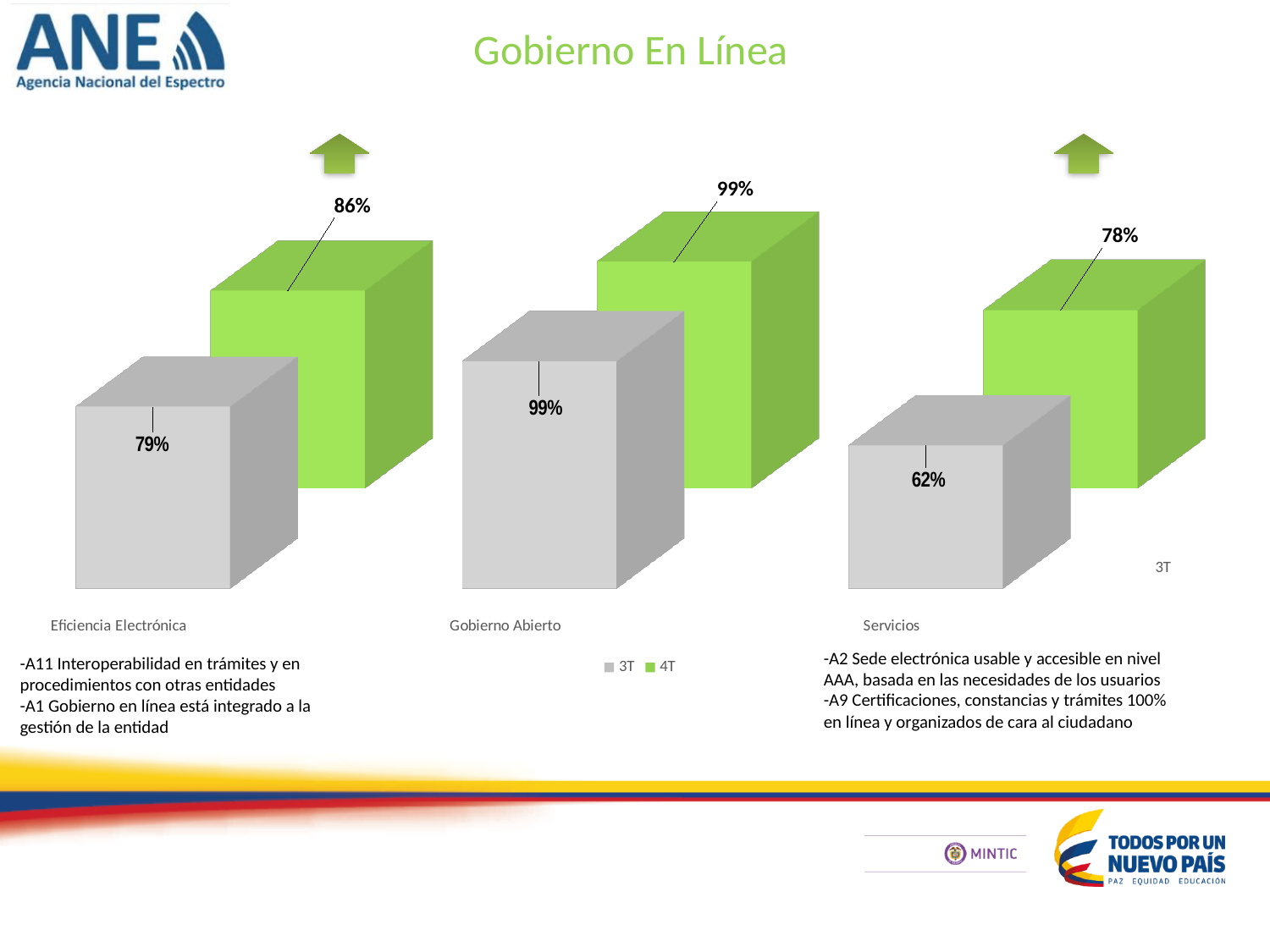
Which category has the highest 4T value? Gobierno Abierto What is the difference between the 4T and 3T values for Servicios? 16% What is the 4T value for Eficiencia Electrónica? 86% What is the 4T value for Servicios? 78% What type of chart is shown on the slide? Bar chart Which is larger for Eficiencia Electrónica, the 3T value or the 4T value? 4T What is the 3T value for Servicios? 62% How many series does the legend list? 2 Which category has the lowest 3T value? Servicios How many categories are shown on the chart? 3 What is the difference between the 4T and 3T values for Eficiencia Electrónica? 7% What is the 3T value for Gobierno Abierto? 99%